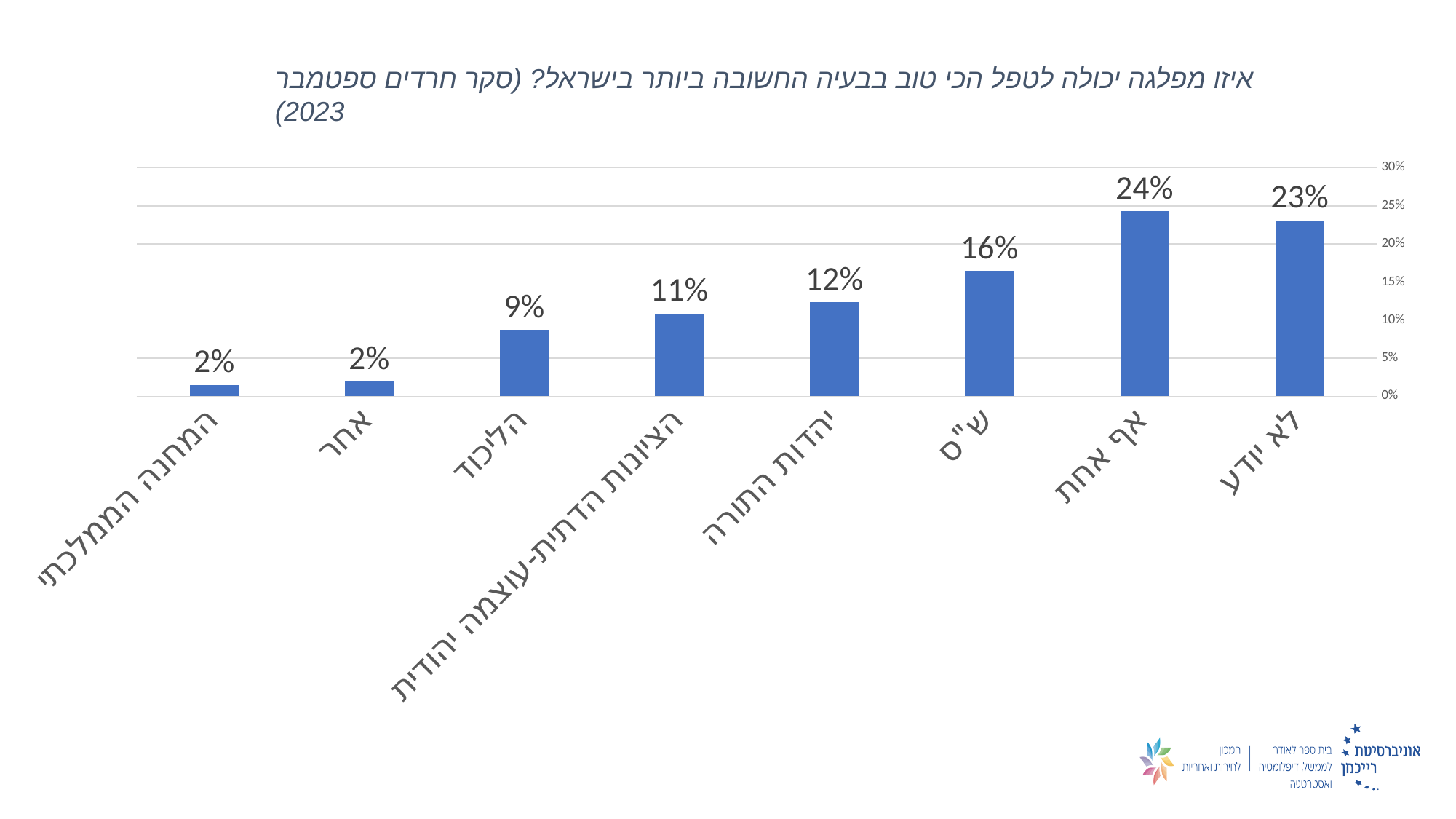
What kind of chart is shown on the slide? bar chart What percentage is shown for "הציונות הדתית-עוצמה יהודית"? 11% Which is larger, the value for "ש"ס" or the value for "יהדות התורה"? ש"ס Which category has the highest value? אף אחת What value is shown for "ש"ס"? 16% Is the value for "הליכוד" greater or less than 10%? less What percentage is shown for "אף אחת"? 24% What is the lowest value shown on the chart? 2% What is the difference between the values for "ש"ס" and "יהדות התורה"? 4 percentage points How many categories are shown on the chart? 8 What is the value for "הליכוד"? 9% What is the difference between the values for "אף אחת" and "לא יודע"? 1 percentage point